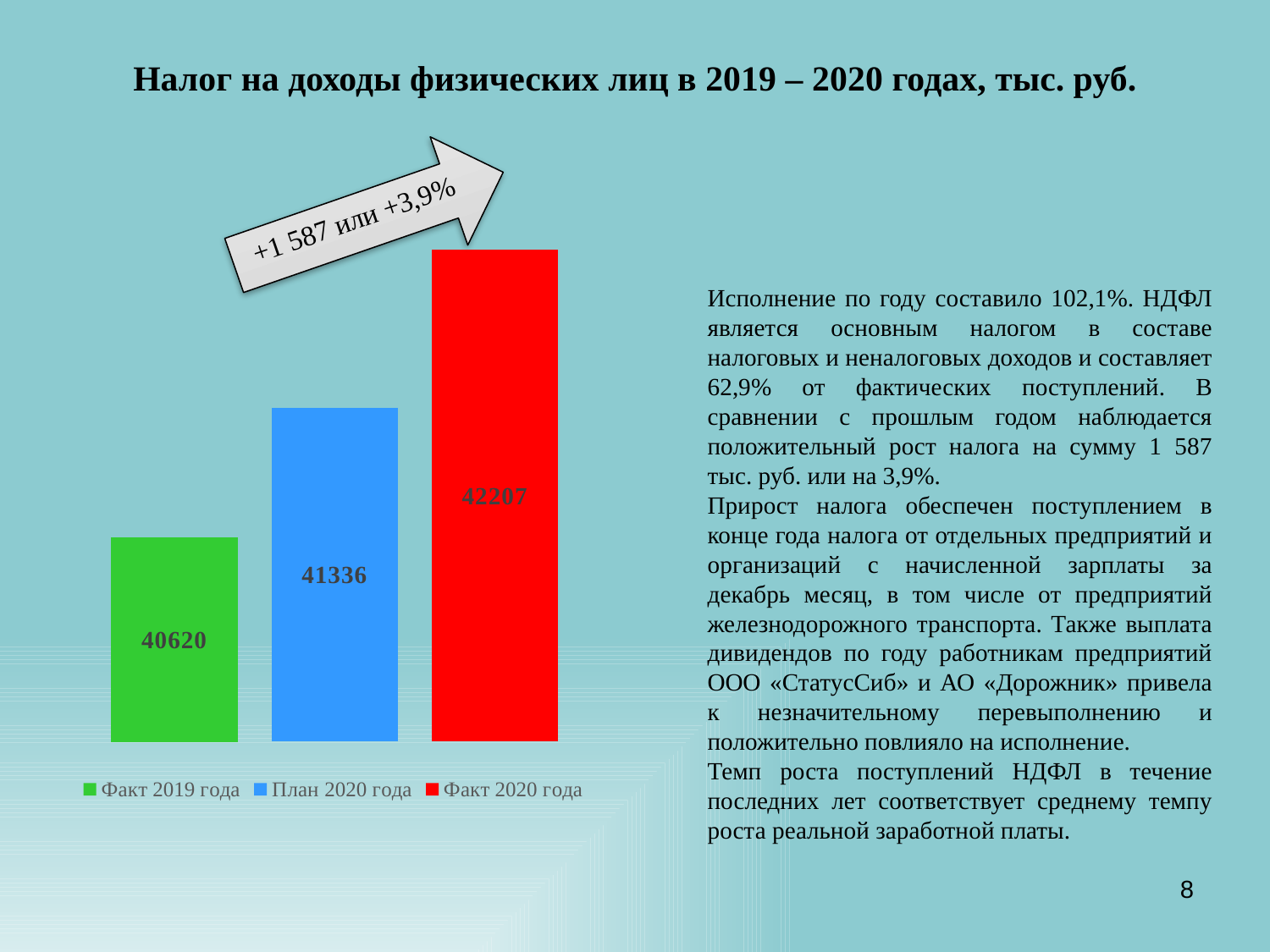
What is the value for План 2020 года? 41336 What is the difference between Факт 2020 года and План 2020 года? 871 What is the value for Факт 2020 года? 42207 What is the value for Факт 2019 года? 40620 What kind of chart is shown on the slide? Bar chart How many bars are plotted in the chart? 3 How many series does the legend list? 3 Which is larger, План 2020 года or Факт 2019 года? План 2020 года What is the difference between Факт 2020 года and Факт 2019 года? 1587 What colour is the bar for Факт 2020 года? Red Which series has the lowest value? Факт 2019 года Which series has the highest value? Факт 2020 года